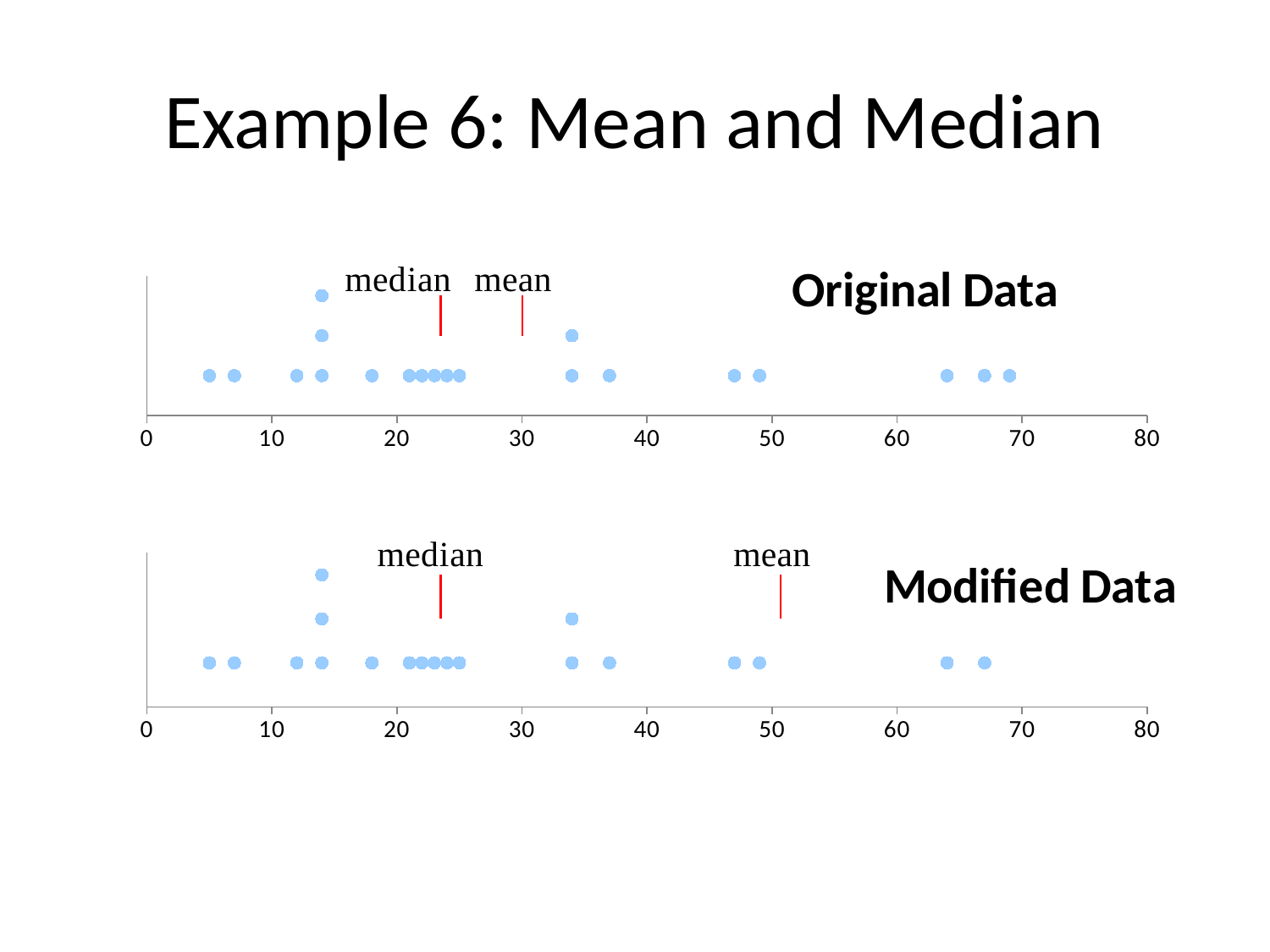
In the Original Data chart, is the median greater or less than 20? greater In the Modified Data chart, which is larger, the mean or the median? mean In the Original Data chart, is the largest data value greater or less than 60? greater What is the maximum value shown on the x axis of the Original Data chart? 80 What kind of chart is shown under the heading "Original Data"? dot plot In the Modified Data chart, is the median greater or less than 30? less How many charts are on the slide? 2 What are the two labels marked by red vertical lines on each chart? median and mean Which chart shows the larger mean, Original Data or Modified Data? Modified Data